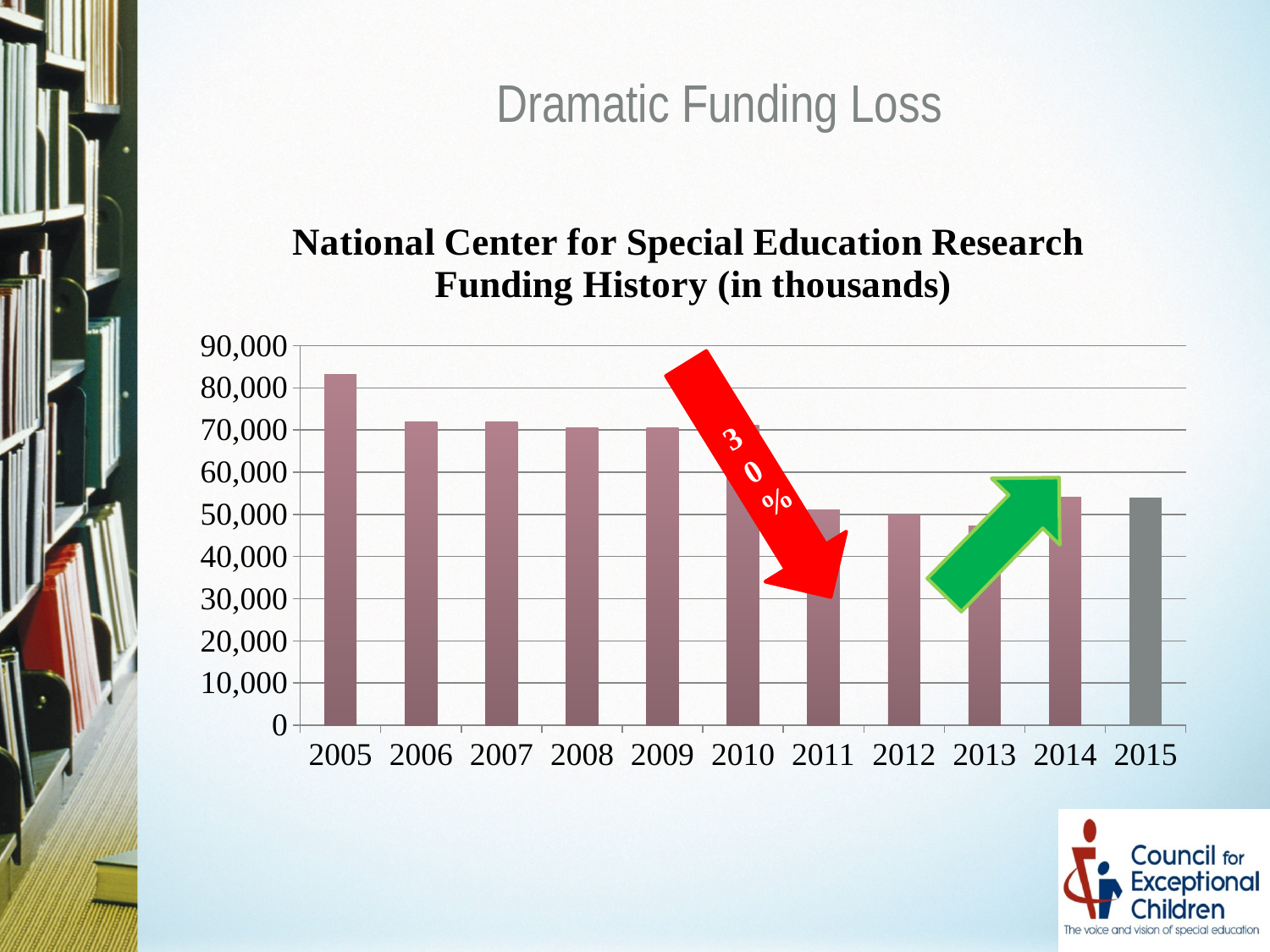
How many years are plotted on the x axis of the chart? 11 Overall, do the funding values rise or fall from 2005 to 2015? fall Which is larger, the value for 2009 or the value for 2015? 2009 Is the value for 2008 greater or less than 80,000? less What kind of chart is shown on the slide? bar chart Which year has the highest funding value in the chart? 2005 Which is larger, the value for 2005 or the value for 2011? 2005 What percentage is written on the red arrow in the chart? 30% Is the value for 2005 greater or less than 80,000? greater Is the value for 2011 greater or less than 60,000? less Which year has the lowest funding value in the chart? 2013